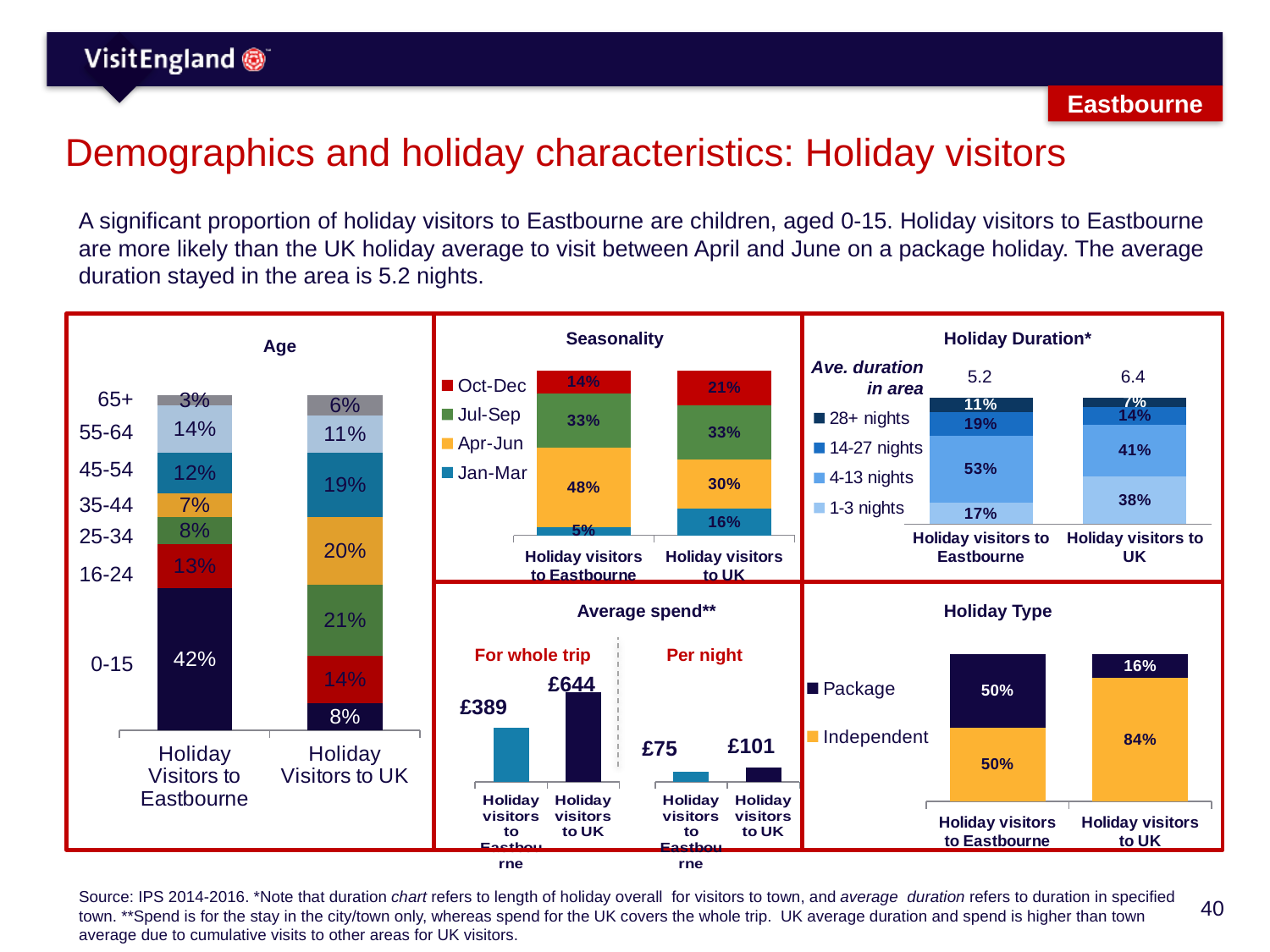
In the Seasonality chart, what percentage of holiday visitors to Eastbourne visit in Apr-Jun? 48% In the Holiday Duration chart, what is the average duration in area for holiday visitors to Eastbourne? 5.2 In the Average spend chart, what is the spend for the whole trip for holiday visitors to UK? £644 In the Average spend chart, what is the difference in per night spend between holiday visitors to UK and holiday visitors to Eastbourne? £26 In the Age chart, what share of holiday visitors to Eastbourne are aged 0-15? 42% In the Seasonality chart, what is the difference between the Apr-Jun share for holiday visitors to Eastbourne and for holiday visitors to UK? 18 percentage points In the Holiday Type chart, what percentage of holiday visitors to UK are on a package holiday? 16% What type of chart is the Average spend chart? Bar chart How many series does the legend of the Seasonality chart list? 4 In the Holiday Duration chart, what share of holiday visitors to Eastbourne stay 4-13 nights? 53% In the Holiday Type chart, which group has the larger Independent share, holiday visitors to Eastbourne or holiday visitors to UK? Holiday visitors to UK In the Age chart, which age group is the largest for holiday visitors to UK? 25-34